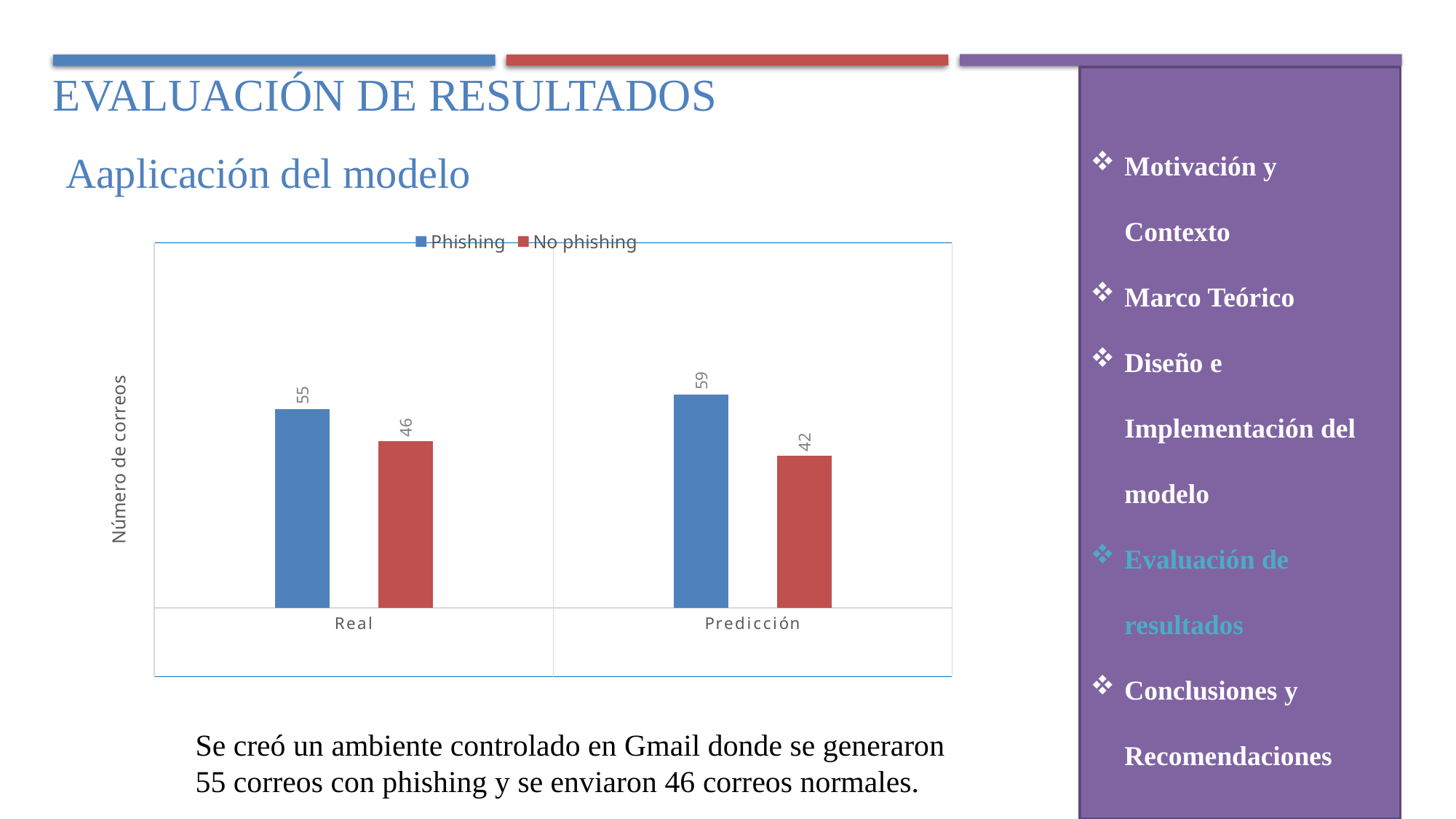
What is the label of the vertical axis? Número de correos What kind of chart is shown on the slide? Bar chart Which category has the lower No phishing value? Predicción Which category has the higher Phishing value, Real or Predicción? Predicción What is the Phishing value for the Real category? 55 How many series does the legend list? 2 How many categories are shown on the x axis? 2 What is the No phishing value for the Predicción category? 42 What is the Phishing value for the Predicción category? 59 What is the difference between the Phishing values for Predicción and Real? 4 What is the difference between the Phishing and No phishing values for the Real category? 9 What is the No phishing value for the Real category? 46